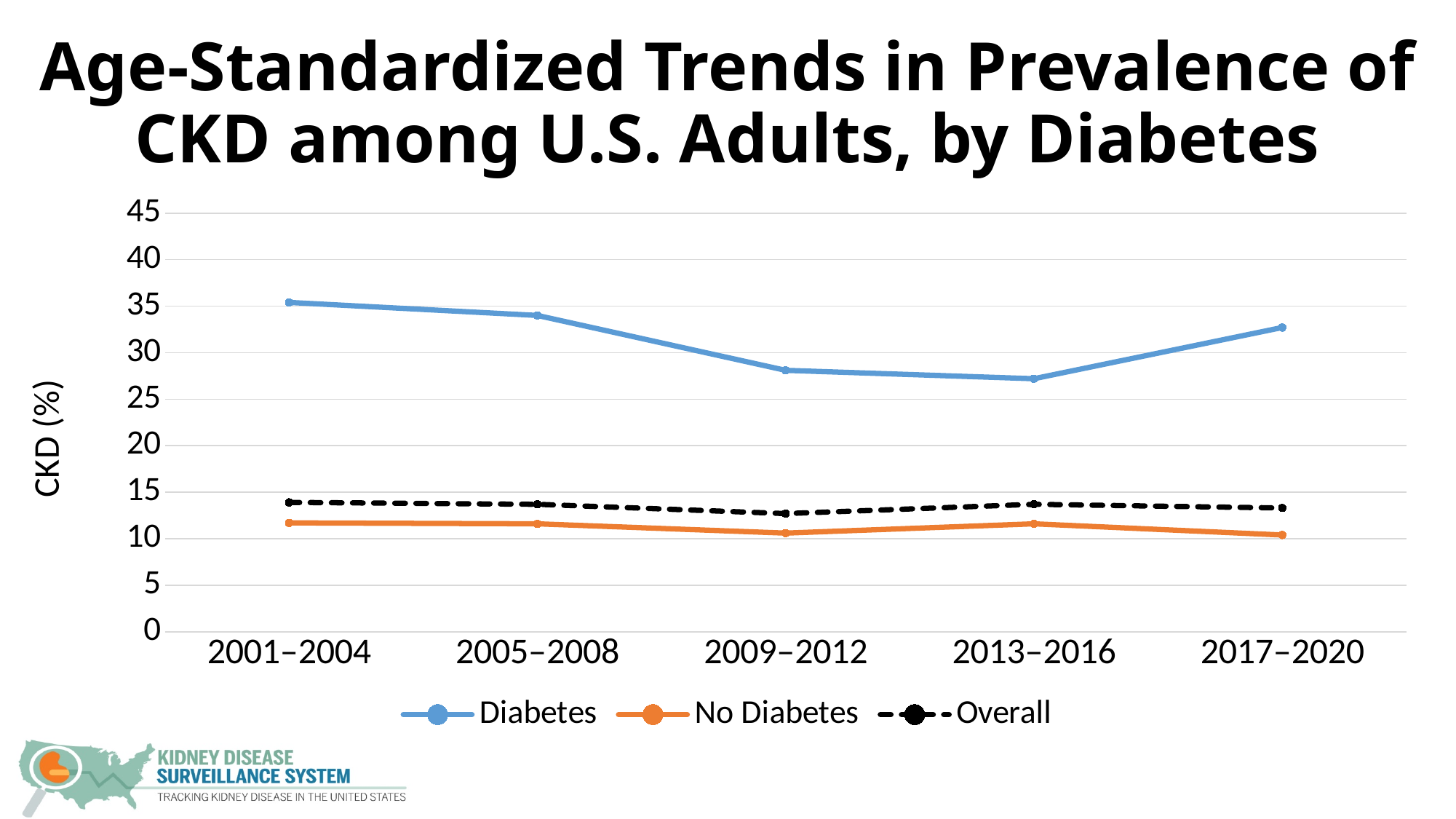
How many time periods are shown on the x axis? 5 Is the value for No Diabetes in 2009–2012 greater or less than 15? less In which period is the Diabetes series at its highest? 2001–2004 Which is larger in 2009–2012, the Overall value or the No Diabetes value? Overall How many series does the legend list? 3 Does the Diabetes series rise or fall from 2001–2004 to 2013–2016? fall Which is larger in 2017–2020, the Diabetes value or the No Diabetes value? Diabetes What kind of chart is shown on the slide? line chart Which series has the highest CKD prevalence across all periods? Diabetes Is the value for Diabetes in 2001–2004 greater or less than 30? greater Is the value for Diabetes in 2013–2016 greater or less than 30? less What is the label on the y axis? CKD (%)